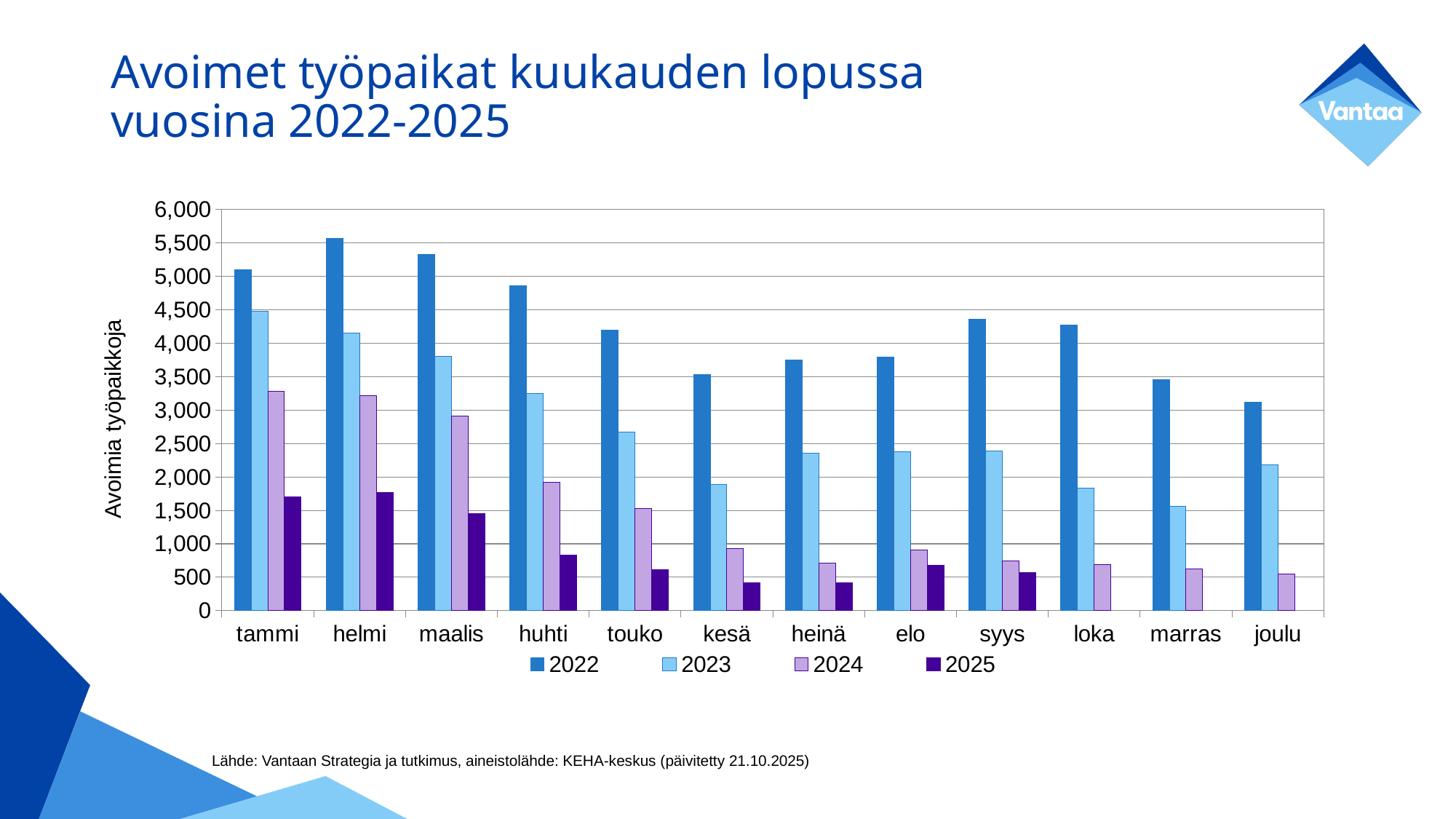
In which month is the 2022 value highest? helmi Does the 2024 series generally rise or fall from tammi to joulu? fall What kind of chart is shown on the slide? bar chart Is the 2023 value for tammi greater or less than 4,000? greater In which month is the 2022 value lowest? joulu How many series does the legend list? 4 What is the label on the vertical axis? Avoimia työpaikkoja In which month is the 2023 value highest? tammi For how many months does the 2025 series have a bar? 9 Is the 2025 value for kesä greater or less than 500? less How many months are shown on the x axis? 12 Which is larger, the 2023 value for joulu or the 2023 value for marras? 2023 joulu